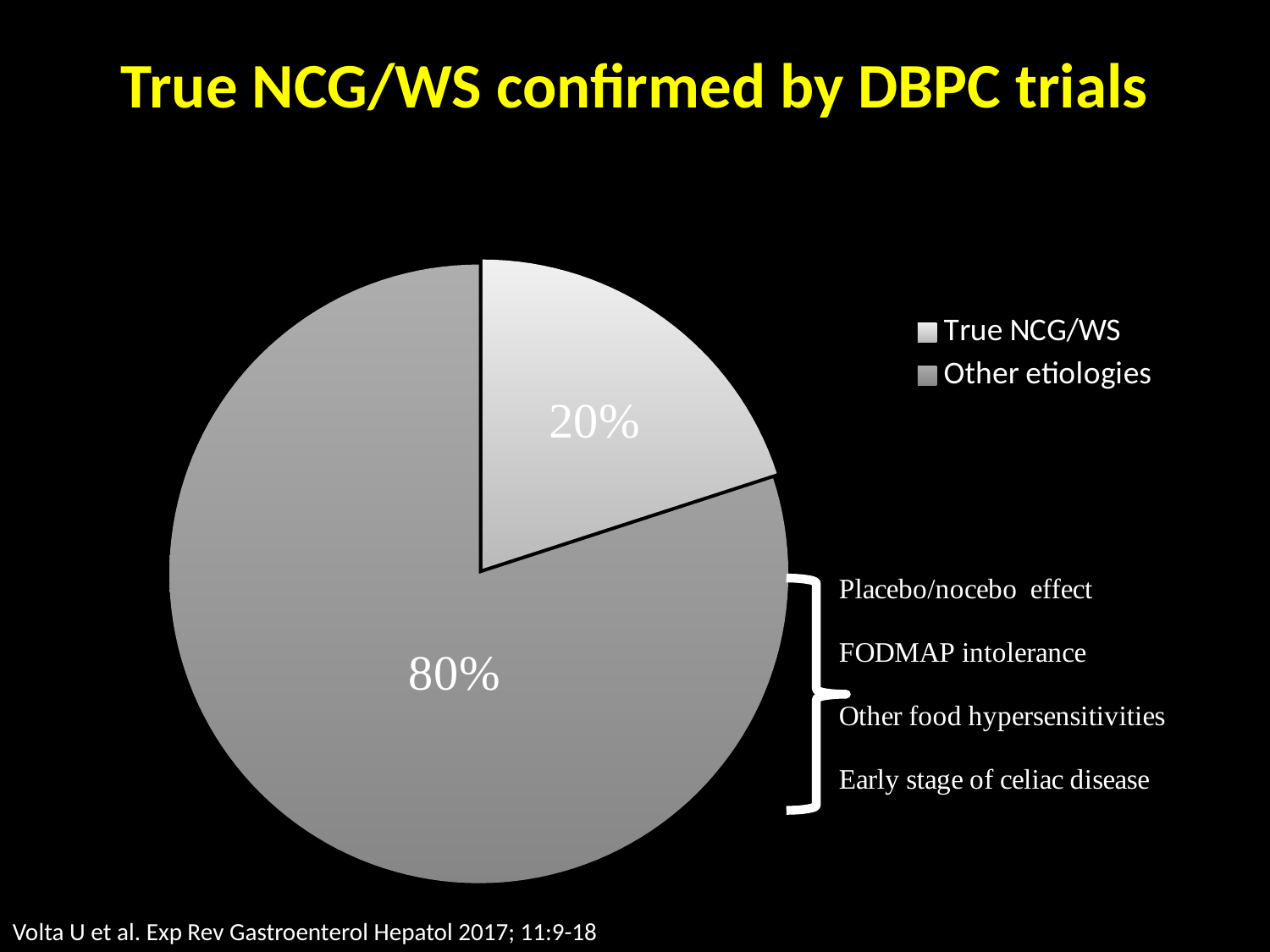
How many slices does the pie chart have? 2 How many entries does the legend list? 2 What is the difference in percentage points between the Other etiologies slice and the True NCG/WS slice? 60 What is the title of the slide containing the pie chart? True NCG/WS confirmed by DBPC trials What share of the pie is labelled Other etiologies? 80% Which is larger, the True NCG/WS slice or the Other etiologies slice? Other etiologies What share of the pie is labelled True NCG/WS? 20% Which slice of the pie is the smallest? True NCG/WS What kind of chart is shown on the slide? pie chart Which slice of the pie is the largest? Other etiologies Which legend entry is shown with the lighter shade of grey? True NCG/WS